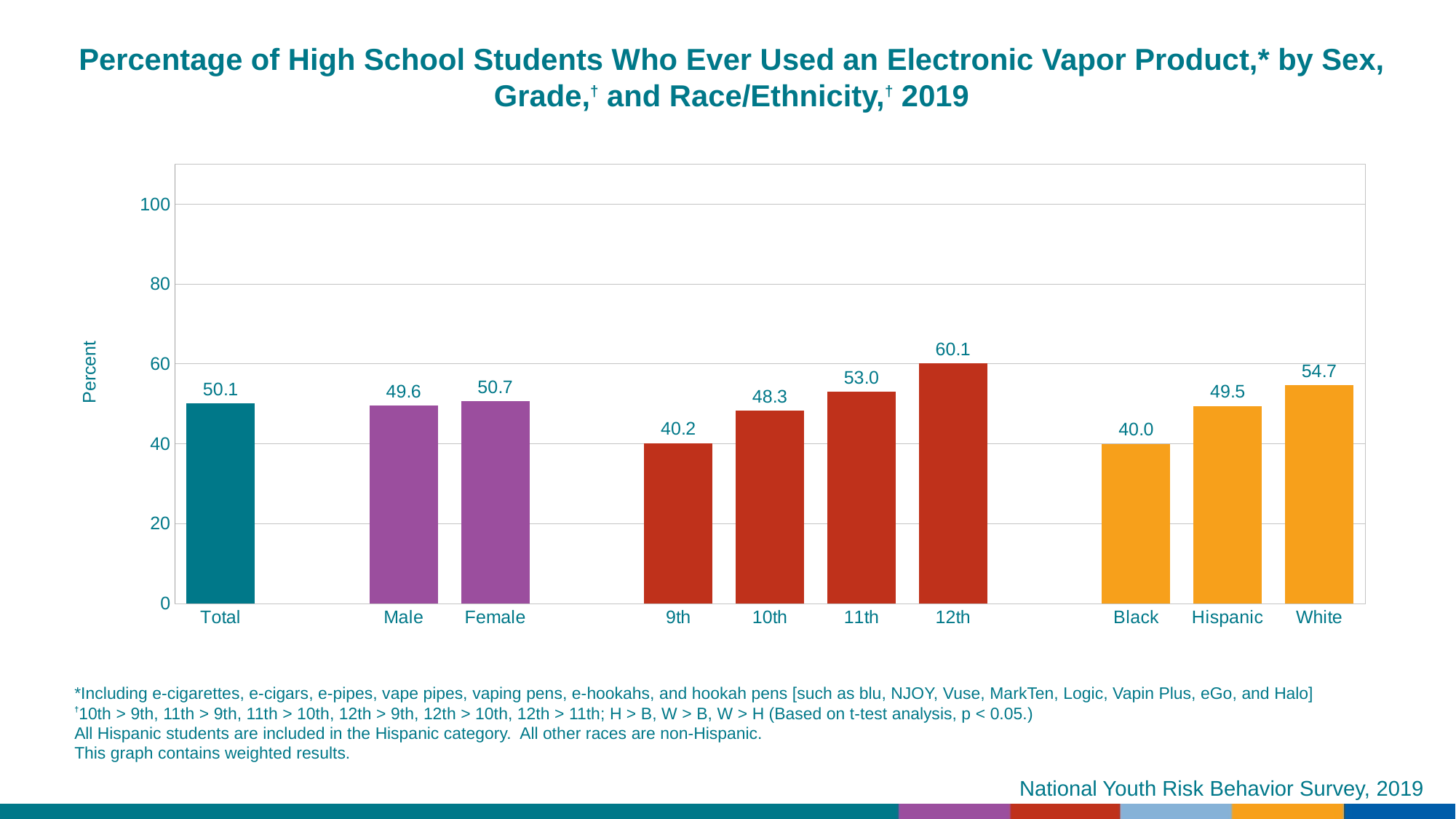
What kind of chart is this? bar chart What is the difference between the values for White and Hispanic students? 5.2 Do the values rise or fall from 9th grade to 12th grade? rise Which category has the lowest value? Black What is the value for 12th grade students? 60.1 Which is larger, the value for Male or the value for Female? Female Is the value for 11th grade greater or less than 40? greater What is the difference between the values for 12th and 9th grade? 19.9 What is the value for Total? 50.1 What is the value for Black students? 40.0 Which category has the highest value? 12th How many categories are shown on the x axis? 10